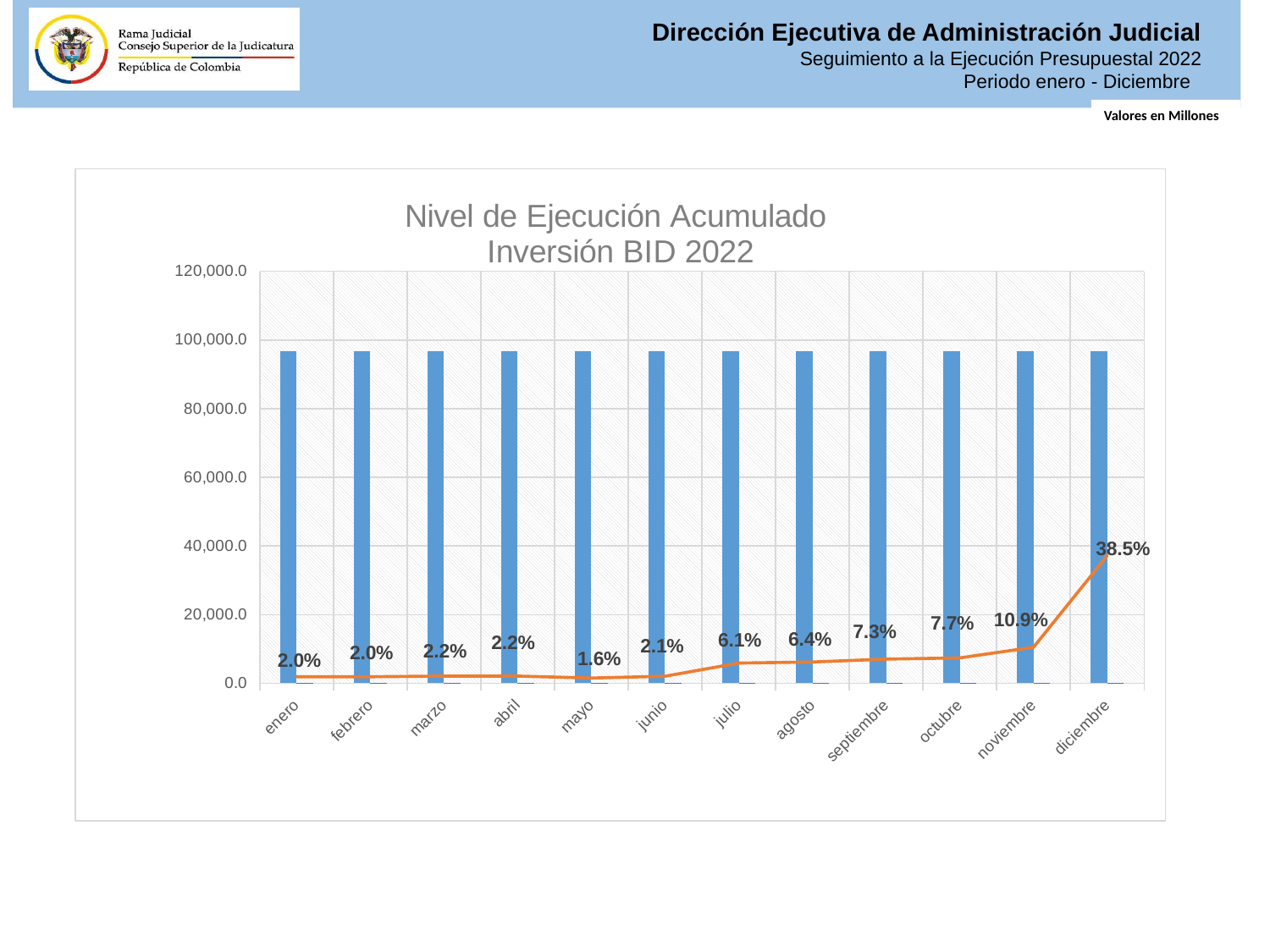
What percentage is labelled for diciembre? 38.5% Is the bar value for enero greater or less than 80,000.0? greater What percentage is labelled for mayo? 1.6% What is the difference in percentage points between the labels for diciembre and noviembre? 27.6 Do the percentage labels generally rise or fall from enero to diciembre? rise What percentage is labelled for julio? 6.1% How many months are shown on the x axis? 12 What percentage is labelled for noviembre? 10.9% Which month has the lowest percentage label? mayo Which has the larger percentage label, agosto or septiembre? septiembre Which month has the highest percentage label? diciembre What is the title of the chart? Nivel de Ejecución Acumulado Inversión BID 2022